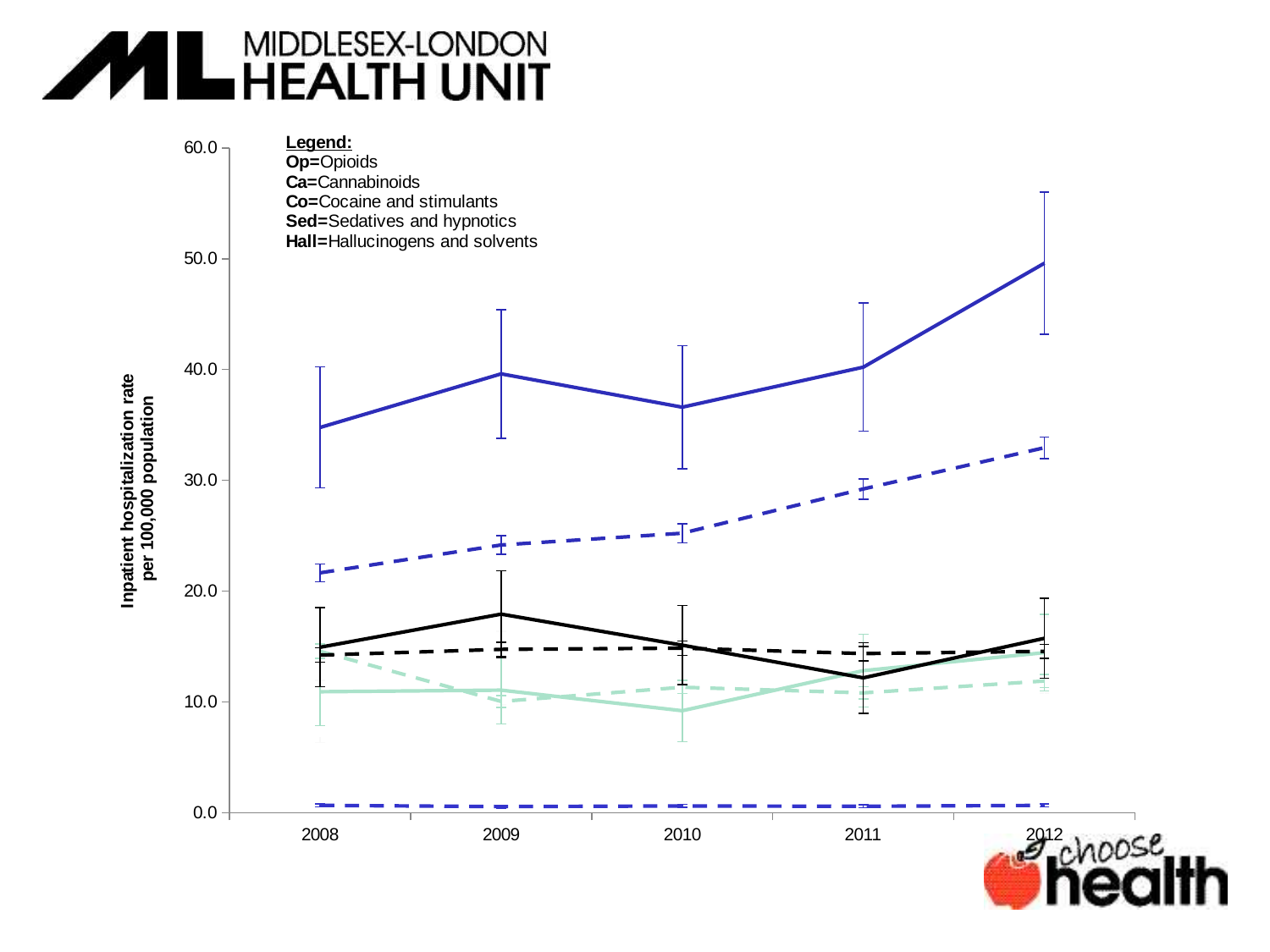
Does the upper dashed blue line rise or fall from 2008 to 2012? rise How many drug categories does the legend on the chart list? 5 Is the value of the top solid blue line in 2012 greater or less than 40? greater Is the value of the upper dashed blue line in 2012 greater or less than 30? greater What is the first year shown on the x axis of the chart? 2008 Does the top solid blue line rise or fall from 2011 to 2012? rise Is the value of the top solid blue line in 2008 greater or less than 30? greater What kind of chart is shown on the slide? line chart In 2012, which is higher: the top solid blue line or the upper dashed blue line? the top solid blue line What is the label of the y axis of the chart? Inpatient hospitalization rate per 100,000 population How many years are shown along the x axis of the chart? 5